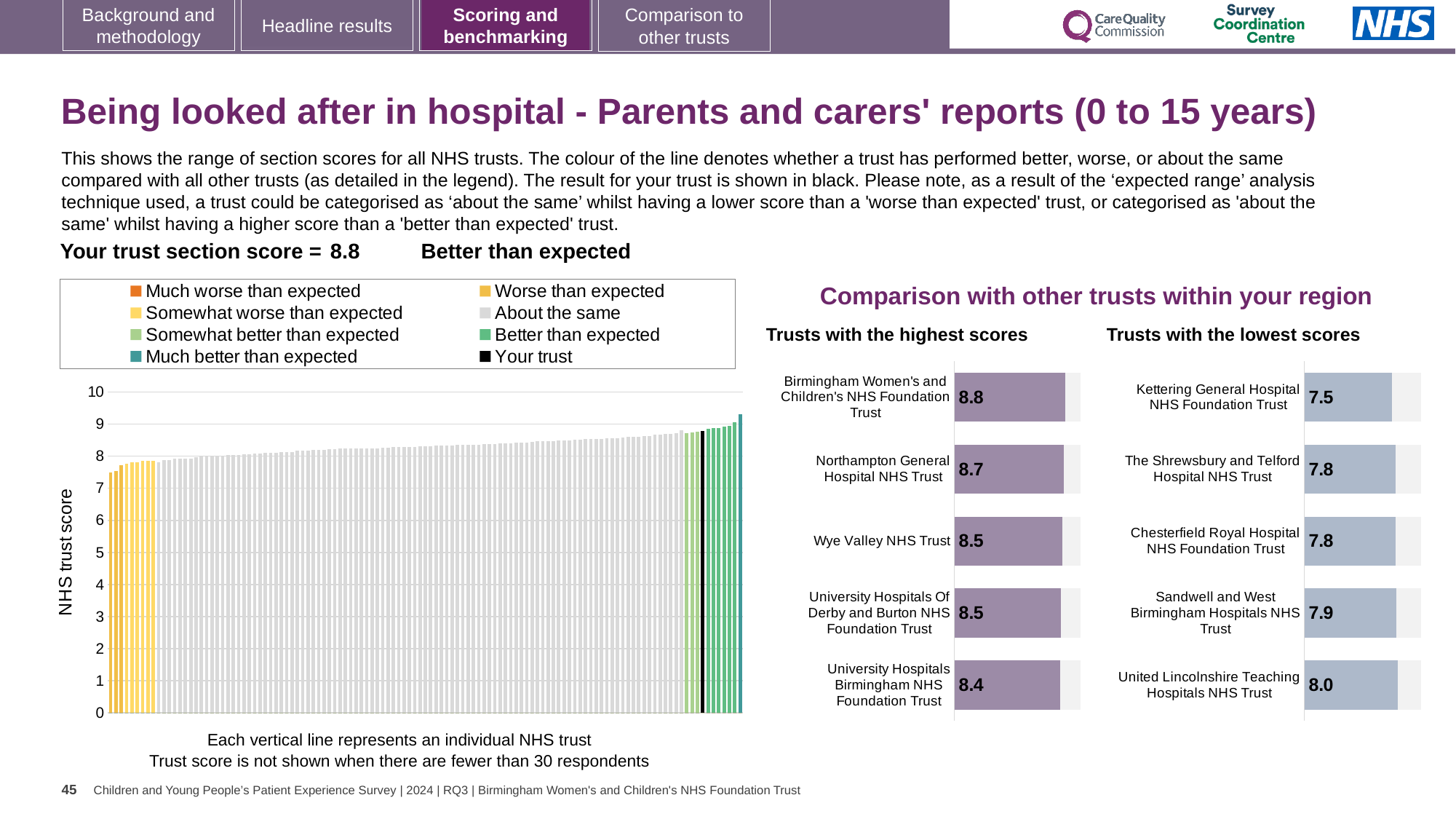
In the left-hand chart of all NHS trusts, is the value of the black bar (your trust) greater or less than 8? greater In the 'Trusts with the highest scores' chart, what is the score for Birmingham Women's and Children's NHS Foundation Trust? 8.8 In the 'Trusts with the lowest scores' chart, which trust has the highest score? United Lincolnshire Teaching Hospitals NHS Trust In the 'Trusts with the lowest scores' chart, what is the difference between the scores of United Lincolnshire Teaching Hospitals NHS Trust and Kettering General Hospital NHS Foundation Trust? 0.5 In the left-hand chart of all NHS trusts, do the bar values rise or fall from left to right? rise In the 'Trusts with the lowest scores' chart, what is the score for Kettering General Hospital NHS Foundation Trust? 7.5 In the 'Trusts with the highest scores' chart, what is the score for Wye Valley NHS Trust? 8.5 How many entries does the legend of the left-hand chart list? 8 In the 'Trusts with the highest scores' chart, how many trusts are shown? 5 In the 'Trusts with the highest scores' chart, which trust has the lowest score? University Hospitals Birmingham NHS Foundation Trust In the 'Trusts with the highest scores' chart, what is the difference between the scores of Birmingham Women's and Children's NHS Foundation Trust and University Hospitals Birmingham NHS Foundation Trust? 0.4 In the 'Trusts with the lowest scores' chart, which has the higher score: Sandwell and West Birmingham Hospitals NHS Trust or Kettering General Hospital NHS Foundation Trust? Sandwell and West Birmingham Hospitals NHS Trust